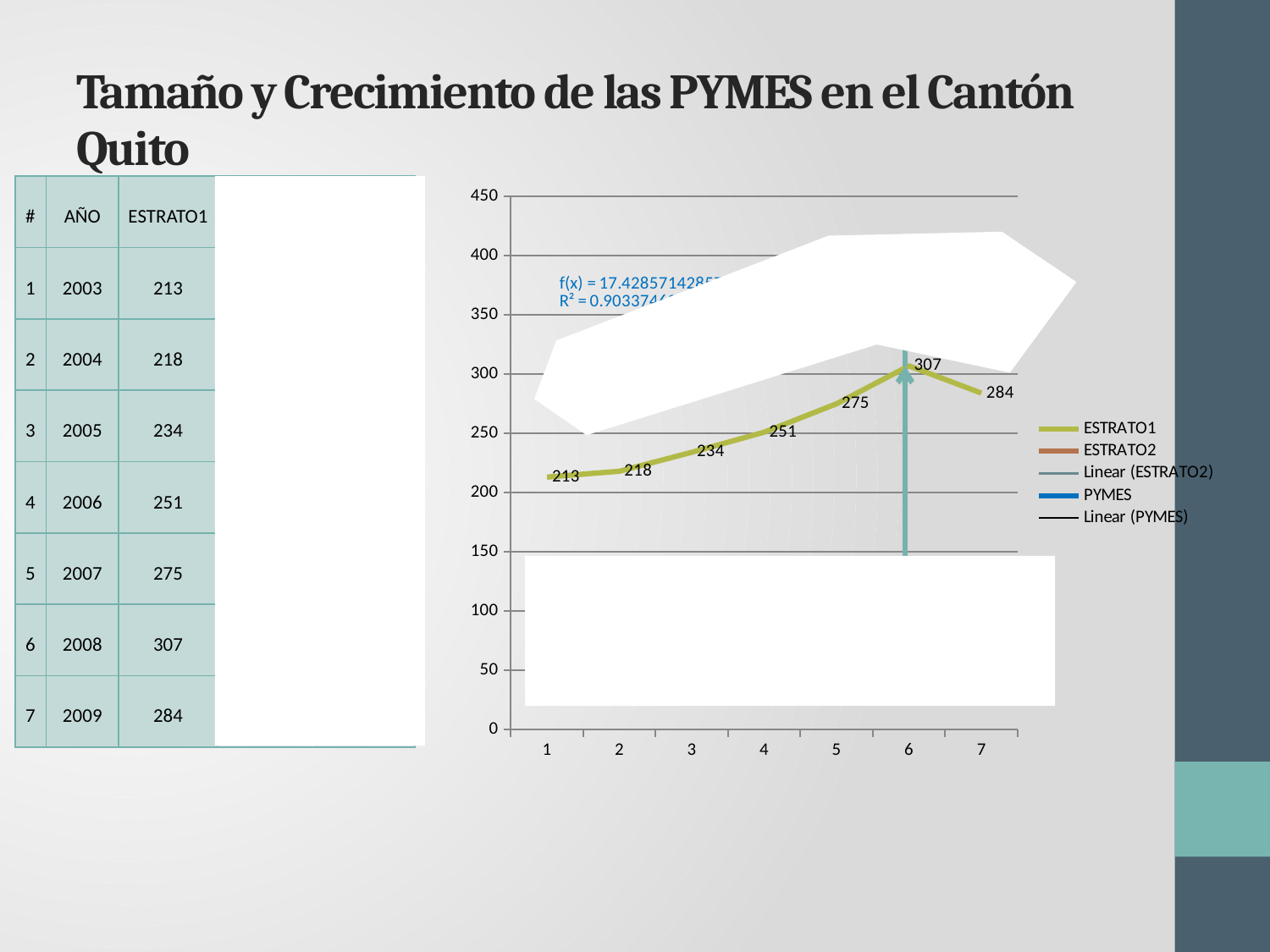
What is the value of ESTRATO1 at x = 7? 284 What is the value of ESTRATO1 at x = 1? 213 At which x value does ESTRATO1 reach its highest value? 6 What is the difference between the ESTRATO1 values at x = 6 and x = 7? 23 Which is larger, the ESTRATO1 value at x = 3 or at x = 4? x = 4 What is the difference between the ESTRATO1 values at x = 5 and x = 4? 24 What is the value of ESTRATO1 at x = 5? 275 How many data points are plotted for ESTRATO1? 7 How many series does the legend list? 5 What is the lowest value plotted for ESTRATO1? 213 Is the ESTRATO1 value at x = 6 greater or less than 300? greater What kind of chart is shown on the slide? line chart